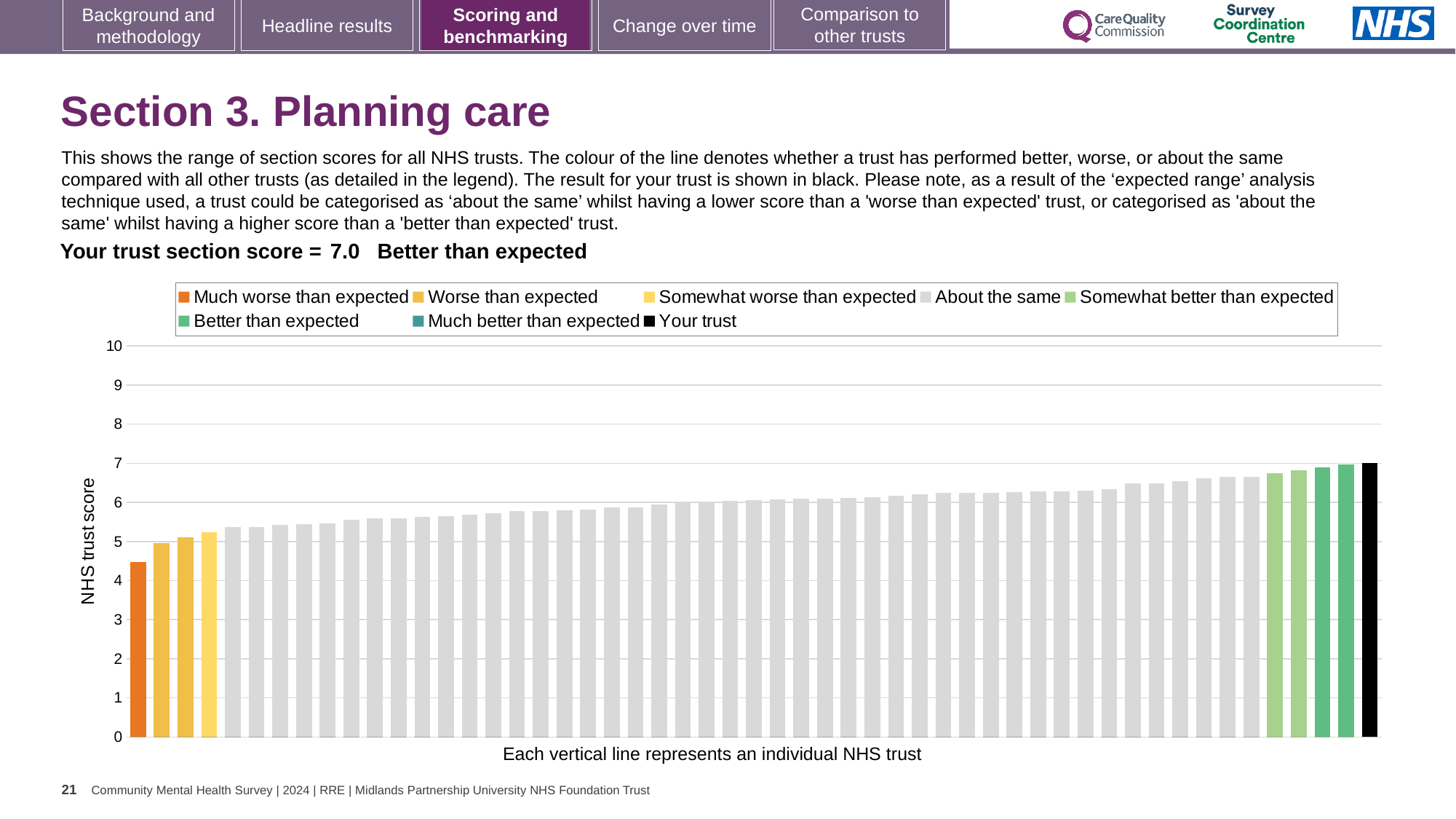
Which bar in the chart is the highest? Your trust (the black bar) How many entries does the chart legend list? 8 What is the section score for your trust? 7.0 Which legend category does the lowest bar in the chart belong to? Much worse than expected Is the value of the lowest bar greater or less than 5? less Do the bar values rise or fall from left to right along the x axis? rise What is the label on the y axis of the chart? NHS trust score Is the value for your trust greater or less than 6? greater How many bars are coloured orange (Much worse than expected)? 1 Which category does the black bar (your trust) fall into according to the text above the chart? Better than expected What colour is used for the bar representing your trust? black What kind of chart is shown on the slide? bar chart